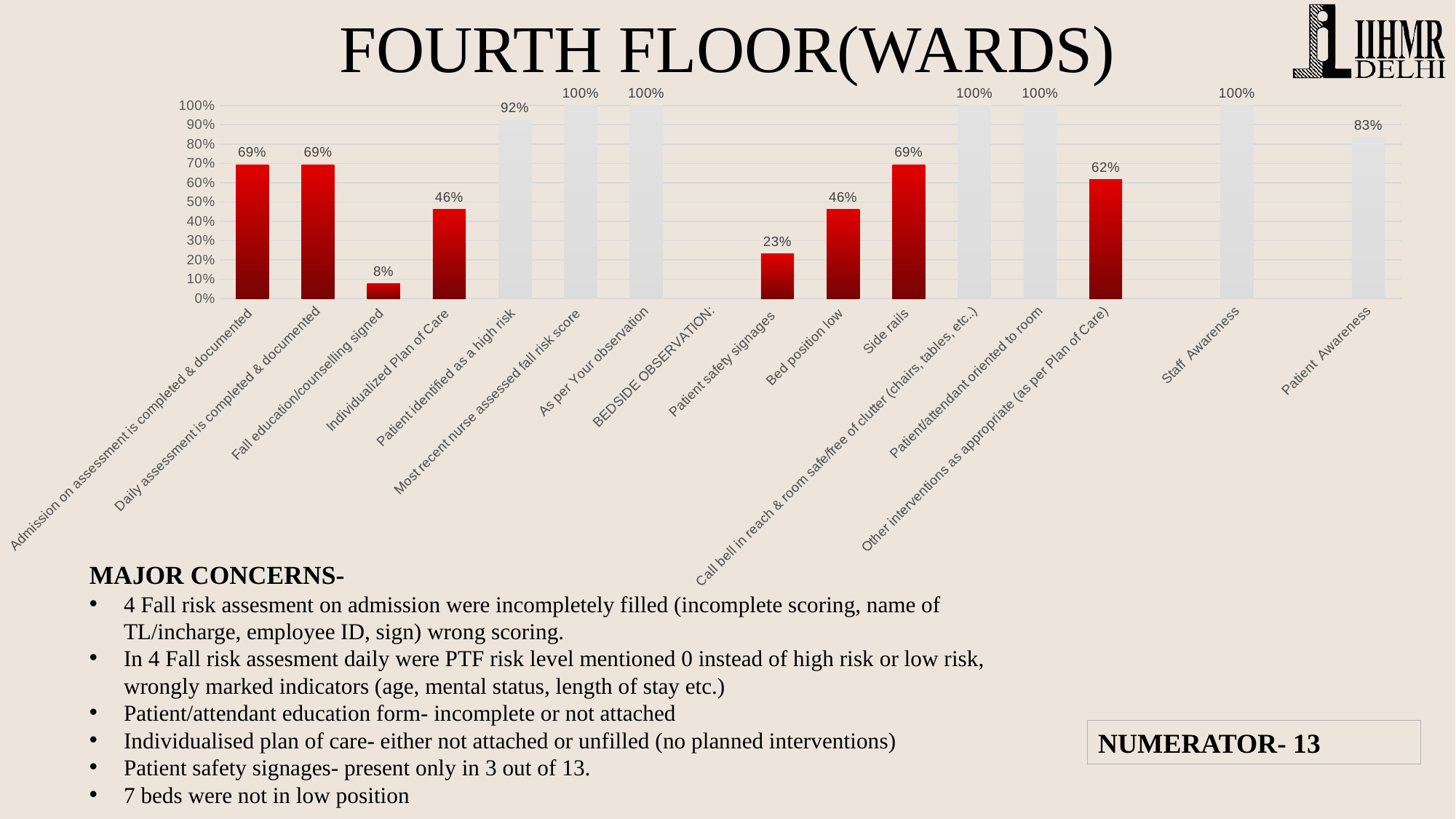
What is the value for Patient safety signages? 23% What kind of chart is shown on the slide? Bar chart What is the value for Other interventions as appropriate (as per Plan of Care)? 62% Which category has the lowest value? Fall education/counselling signed Which is larger, Staff Awareness or Patient Awareness? Staff Awareness What is the difference between Side rails and Bed position low? 23 percentage points What is the title of the slide containing the chart? FOURTH FLOOR(WARDS) What is the difference between Patient Awareness and Other interventions as appropriate (as per Plan of Care)? 21 percentage points Is the value for Other interventions as appropriate (as per Plan of Care) greater or less than 50%? greater What is the value for Fall education/counselling signed? 8% What is the value for Patient identified as a high risk? 92% What is the value for Patient Awareness? 83%